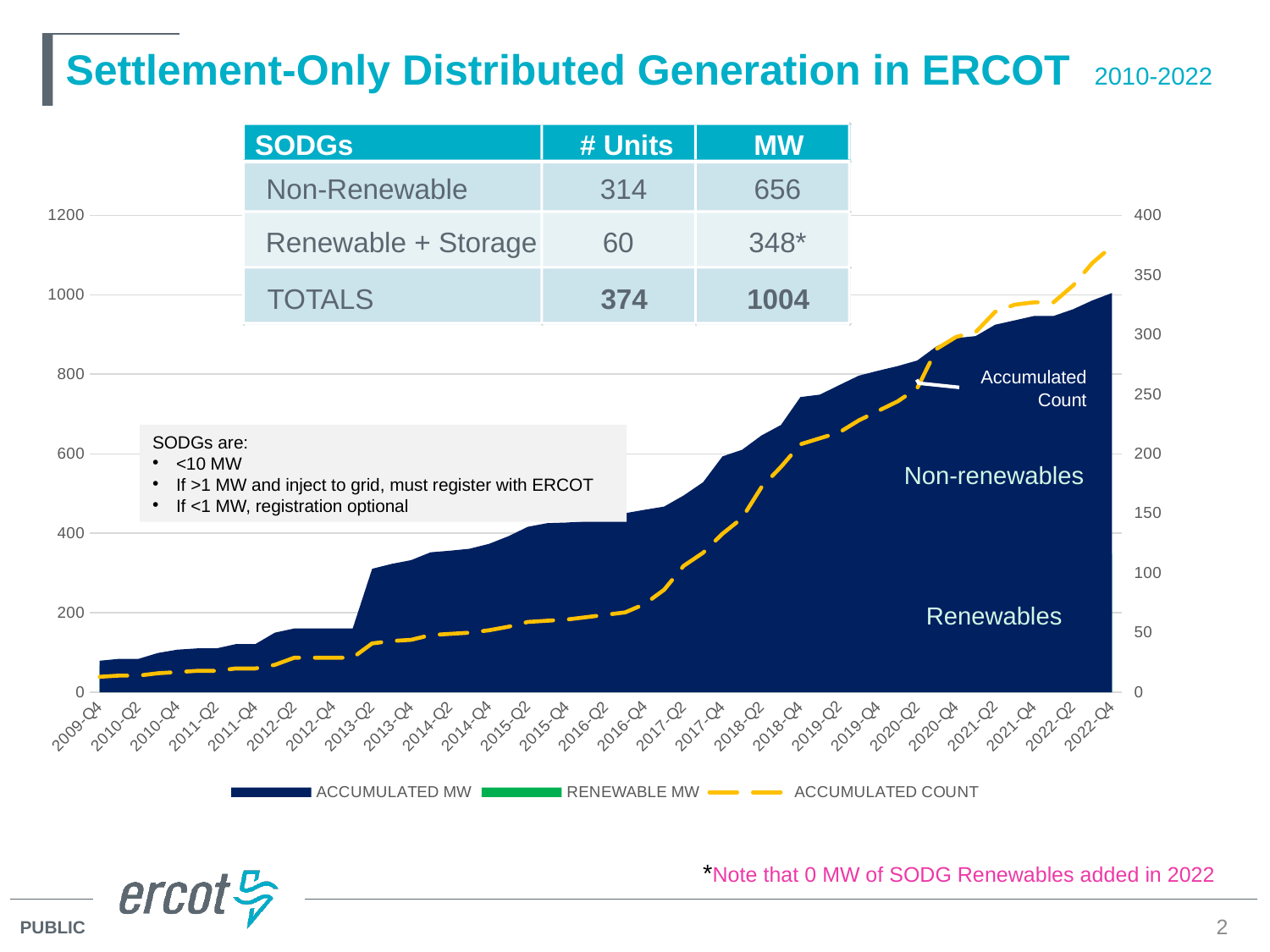
Is the ACCUMULATED MW value at 2018-Q4 greater or less than 600? greater Is the ACCUMULATED COUNT value at 2022-Q4 greater or less than 350 on the right axis? greater How many series does the chart legend list? 3 What kind of chart is shown on the slide? area chart with a line Does the ACCUMULATED COUNT line rise or fall across the x axis? rise Is the ACCUMULATED MW value at 2010-Q2 greater or less than 200? less Does the ACCUMULATED MW series rise or fall from 2009-Q4 to 2022-Q4? rise Which series is drawn as a dashed yellow line? ACCUMULATED COUNT What is the maximum value shown on the left vertical axis? 1200